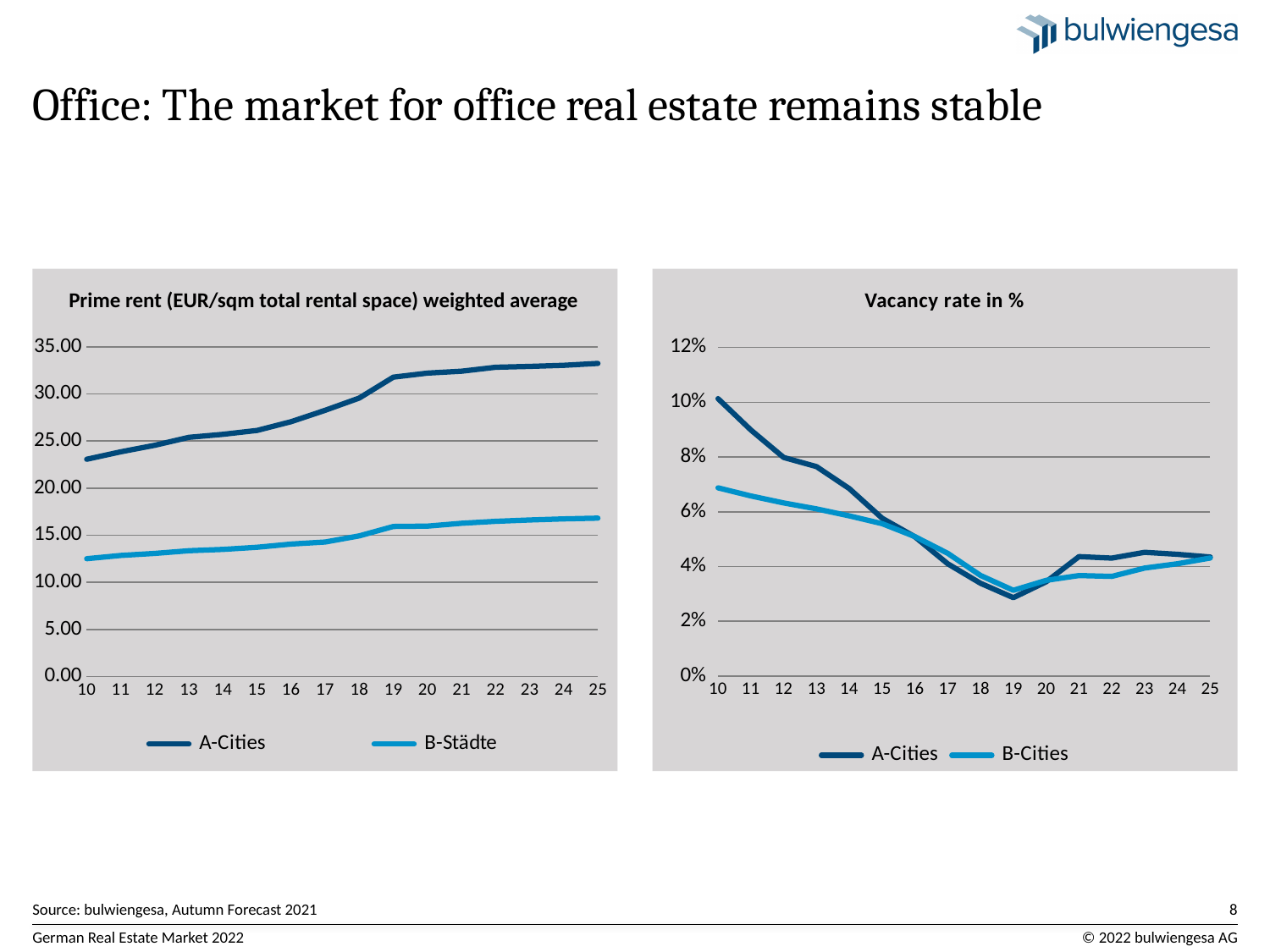
In the 'Prime rent (EUR/sqm total rental space) weighted average' chart, is the value for B-Städte in 10 greater or less than 15.00? less How many series does the legend of the 'Vacancy rate in %' chart list? 2 In the 'Vacancy rate in %' chart, is the value for A-Cities in 19 greater or less than 4%? less In the 'Vacancy rate in %' chart, which series has the higher value in 10, A-Cities or B-Cities? A-Cities In the 'Vacancy rate in %' chart, is the value for B-Cities in 10 greater or less than 6%? greater In the 'Prime rent (EUR/sqm total rental space) weighted average' chart, does the A-Cities line rise or fall from 10 to 25? rise What kind of chart is the 'Prime rent (EUR/sqm total rental space) weighted average' chart? line chart In the 'Vacancy rate in %' chart, does the A-Cities line rise or fall from 10 to 19? fall What is the title of the chart on the right side of the slide? Vacancy rate in % How many years are shown on the x axis of the 'Prime rent (EUR/sqm total rental space) weighted average' chart? 16 In the 'Prime rent (EUR/sqm total rental space) weighted average' chart, which series has the higher value in 25, A-Cities or B-Städte? A-Cities